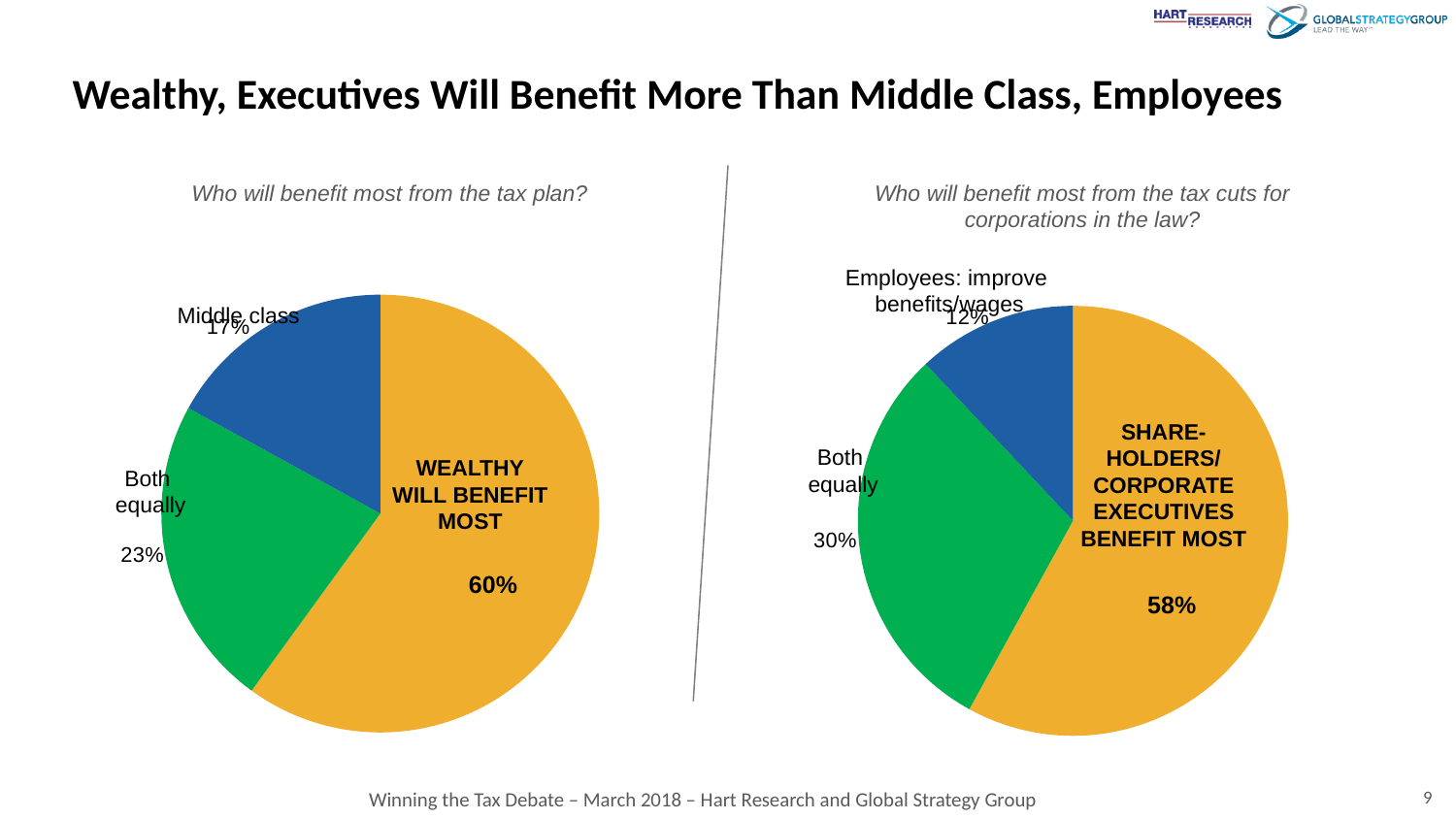
What type of chart is the left chart, 'Who will benefit most from the tax plan?'? Pie chart In the left chart, 'Who will benefit most from the tax plan?', which response has the smallest slice? Middle class In the right chart, 'Who will benefit most from the tax cuts for corporations in the law?', which response has the largest slice? Shareholders/corporate executives benefit most In the right chart, 'Who will benefit most from the tax cuts for corporations in the law?', how many percentage points larger is the 'both equally' slice than the 'employees' slice? 18 percentage points In the right chart, 'Who will benefit most from the tax cuts for corporations in the law?', what share says employees will benefit most? 12% In the left chart, 'Who will benefit most from the tax plan?', how many percentage points larger is the 'wealthy will benefit most' slice than the 'both equally' slice? 37 percentage points In the left chart, 'Who will benefit most from the tax plan?', what share says the wealthy will benefit most? 60% In the right chart, 'Who will benefit most from the tax cuts for corporations in the law?', what share says both will benefit equally? 30% In the left chart, 'Who will benefit most from the tax plan?', what share says the middle class will benefit most? 17% In the left chart, 'Who will benefit most from the tax plan?', what share says both will benefit equally? 23% How many slices does the right chart, 'Who will benefit most from the tax cuts for corporations in the law?', have? 3 In the right chart, 'Who will benefit most from the tax cuts for corporations in the law?', what share says shareholders/corporate executives will benefit most? 58%